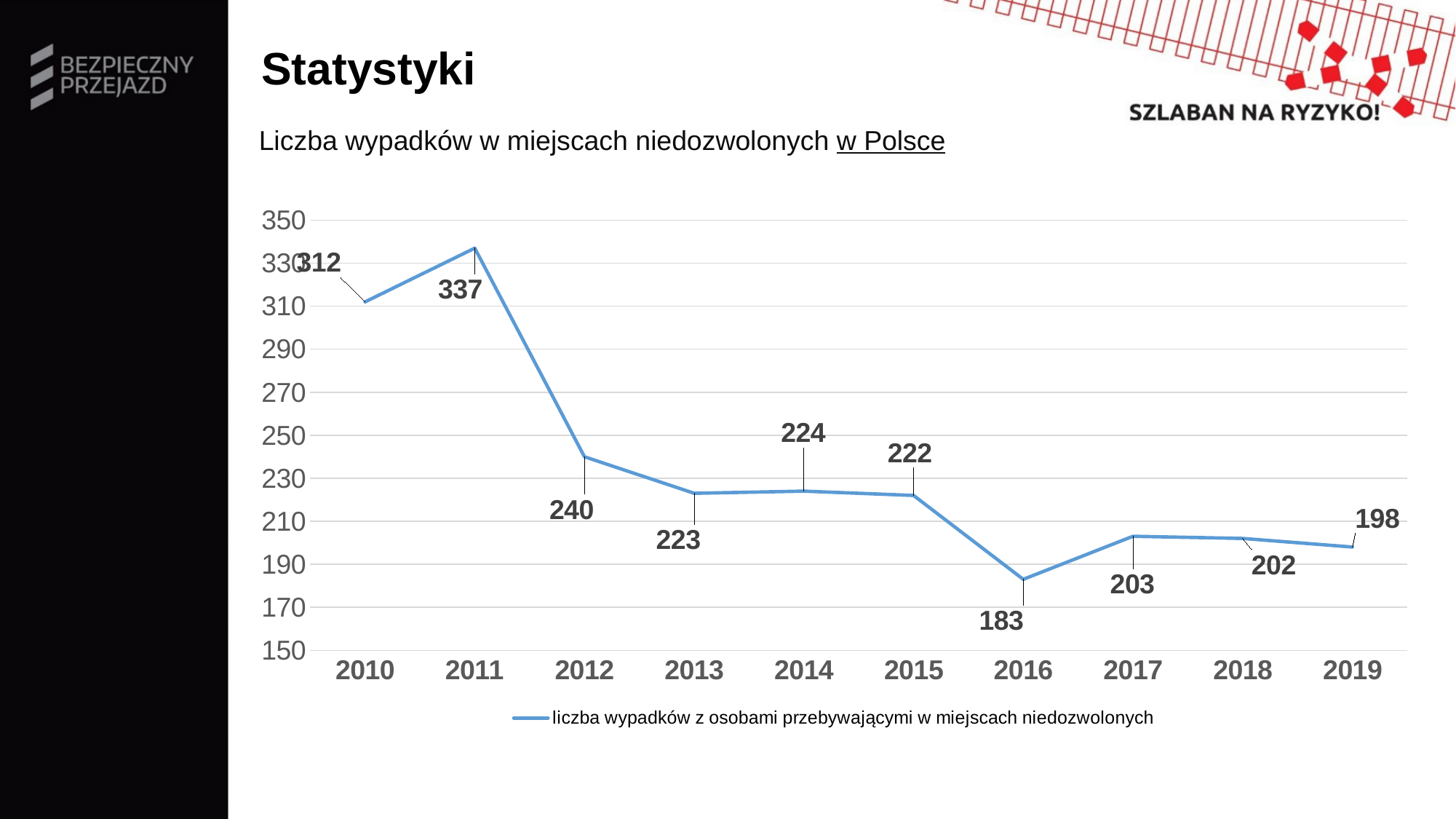
What type of chart is shown on the slide? line chart How many years are plotted on the x axis? 10 Which is larger, the value for 2017 or the value for 2018? 2017 What is the value for 2011? 337 What is the value for 2016? 183 Overall, do the values rise or fall from 2010 to 2019? fall What is the difference between the values for 2011 and 2012? 97 How many series does the legend list? 1 What is the value for 2014? 224 Which year has the highest value? 2011 Which year has the lowest value? 2016 What is the value for 2019? 198